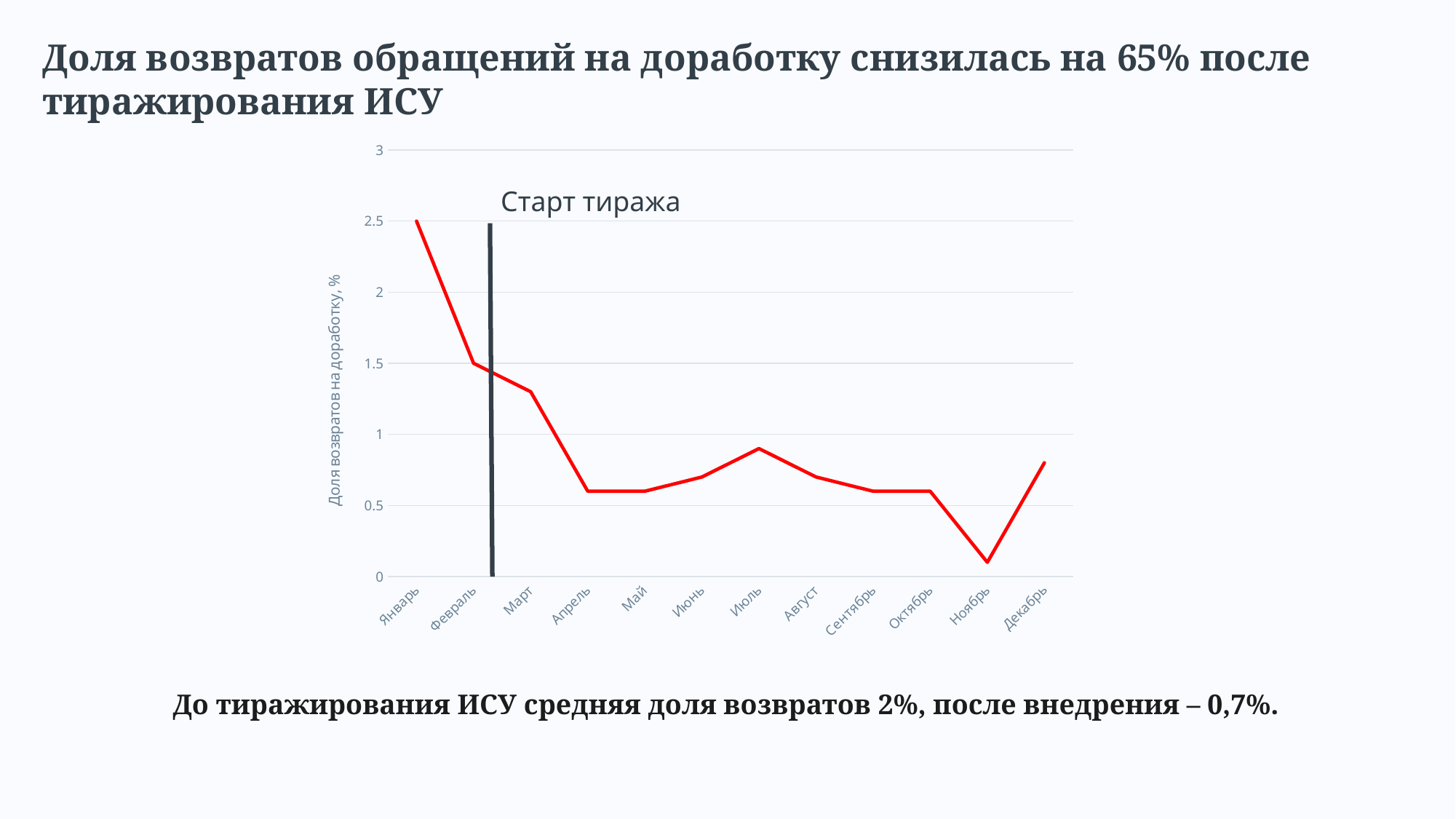
Is the value for Ноябрь greater or less than 0.5? less How many months are plotted along the x axis of the chart? 12 Which is larger, the value for Июль or the value for Ноябрь? Июль What is the value for Февраль on the chart? 1.5 What is the difference between the values for Январь and Февраль? 1 Which month has the lowest share of returns for rework? Ноябрь What is the value for Январь on the chart? 2.5 Do the values generally rise or fall from Январь to Декабрь? fall What label is attached to the vertical line on the chart? Старт тиража What kind of chart is shown on the slide? line chart Which month has the highest share of returns for rework? Январь Is the value for Март greater or less than 1? greater